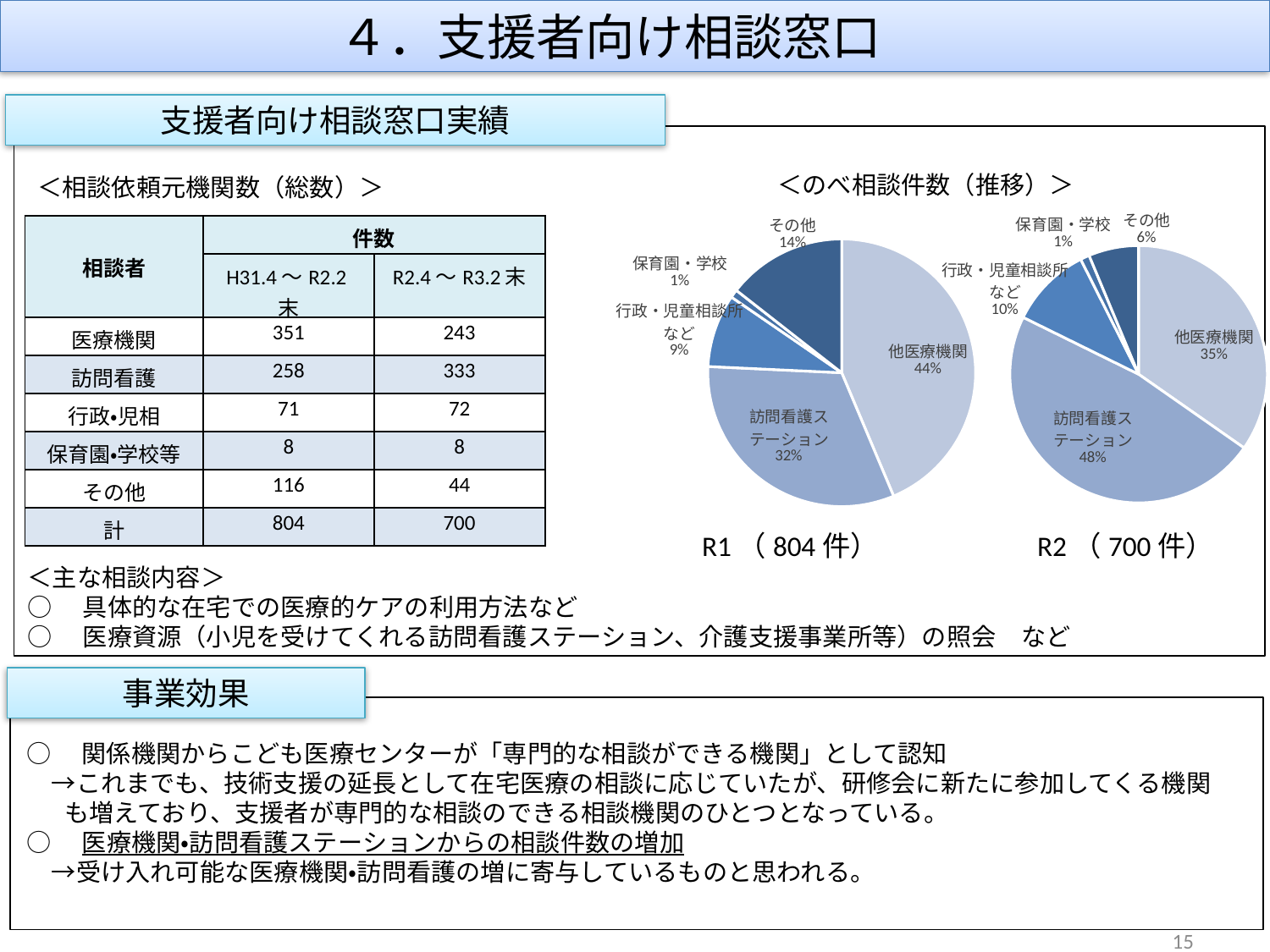
R1（804件）の円グラフで、最も割合が大きい区分はどれですか？ 他医療機関 「のべ相談件数（推移）」の右側の円グラフのタイトル（件数）は何ですか？ R2（700件） R1（804件）の円グラフには、いくつの区分がありますか？ 5 R2（700件）の円グラフで、訪問看護ステーションの割合はいくらですか？ 48% R1（804件）の円グラフで、他医療機関と訪問看護ステーションの割合の差は何ポイントですか？ 12ポイント R1（804件）の円グラフで、その他の割合はいくらですか？ 14% 「のべ相談件数（推移）」に示されているグラフの種類は何ですか？ 円グラフ R2（700件）の円グラフで、行政・児童相談所などの割合はいくらですか？ 10% R1（804件）の円グラフで、他医療機関の割合はいくらですか？ 44% R2（700件）の円グラフで、最も割合が大きい区分はどれですか？ 訪問看護ステーション R2（700件）の円グラフで、その他と行政・児童相談所などでは、どちらの割合が大きいですか？ 行政・児童相談所など R2（700件）の円グラフで、最も割合が小さい区分はどれですか？ 保育園・学校